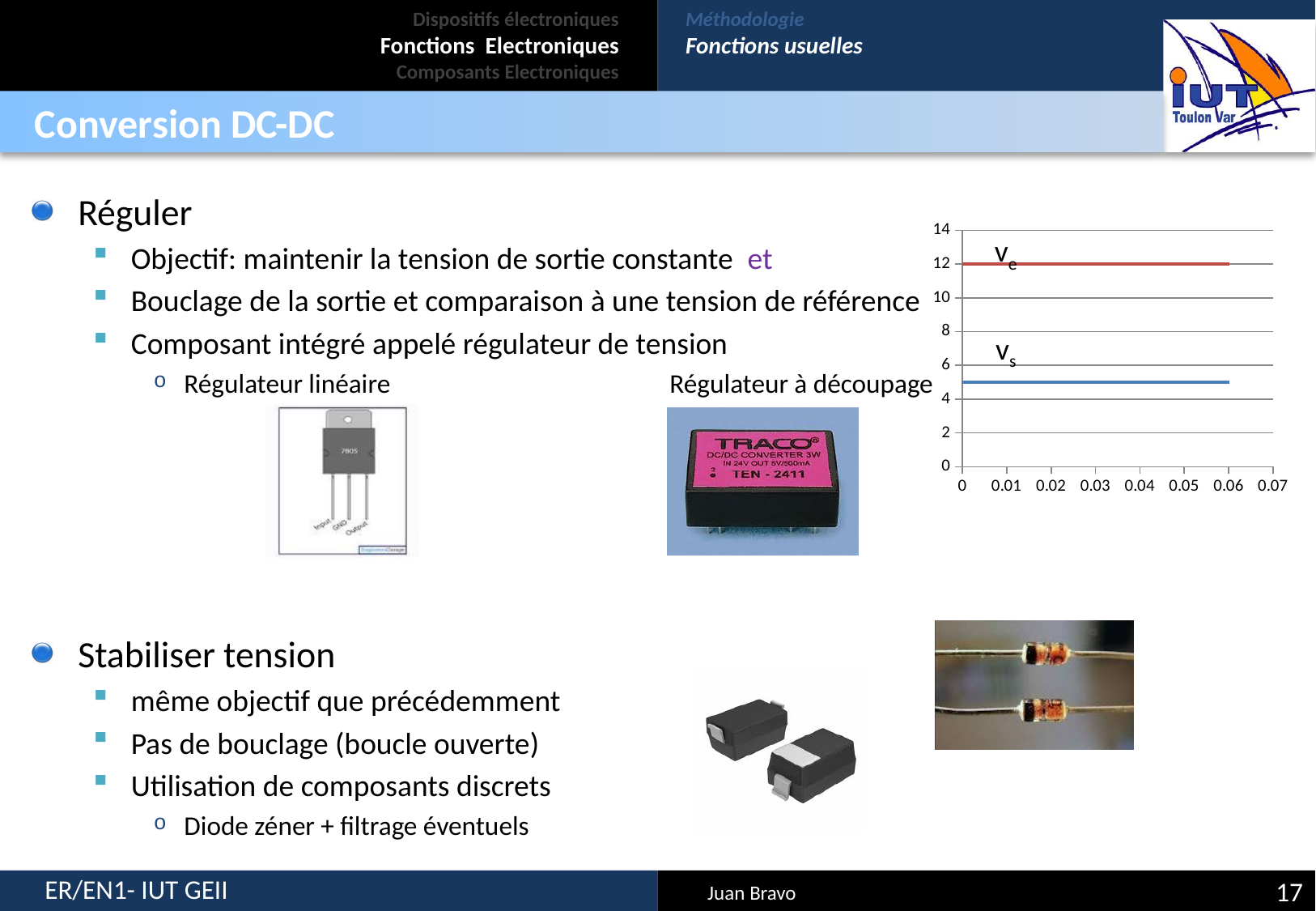
Do the values of the Ve line rise, fall or stay constant along the x axis? stay constant What is the highest value shown on the y axis of the chart? 14 Which of the two plotted series has the lowest value? Vs What kind of chart is shown on the slide? line chart Is the value of the Vs line greater or less than 4? greater How many series are plotted on the chart? 2 Which line is higher on the chart, Ve or Vs? Ve What value does the Ve line sit at on the y axis? 12 Is the value of the Ve line greater or less than 10? greater What is the last tick label on the x axis of the chart? 0.07 Is the value of the Vs line greater or less than 6? less